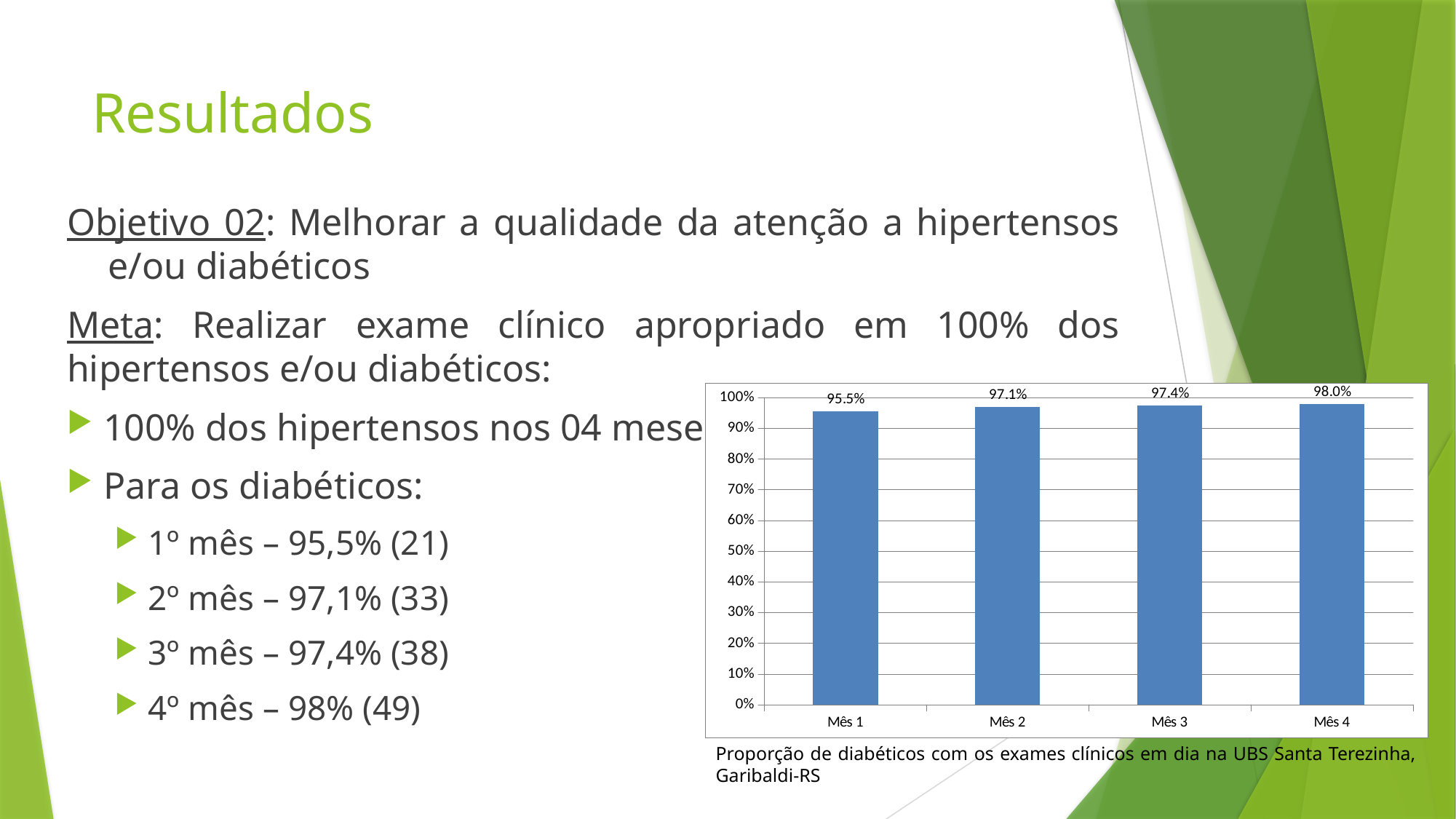
What kind of chart is shown on the slide? bar chart Which month has the highest value in the chart? Mês 4 What is the difference between the values for Mês 4 and Mês 1? 2.5% What is the value for Mês 4 in the chart? 98.0% What is the value for Mês 3 in the chart? 97.4% Which is larger, the value for Mês 2 or the value for Mês 1? Mês 2 Do the values rise or fall from Mês 1 to Mês 4? rise What is the value for Mês 2 in the chart? 97.1% How many months are shown on the x axis of the chart? 4 Which month has the lowest value in the chart? Mês 1 Is the value for Mês 1 greater or less than 90%? greater What is the value for Mês 1 in the chart? 95.5%